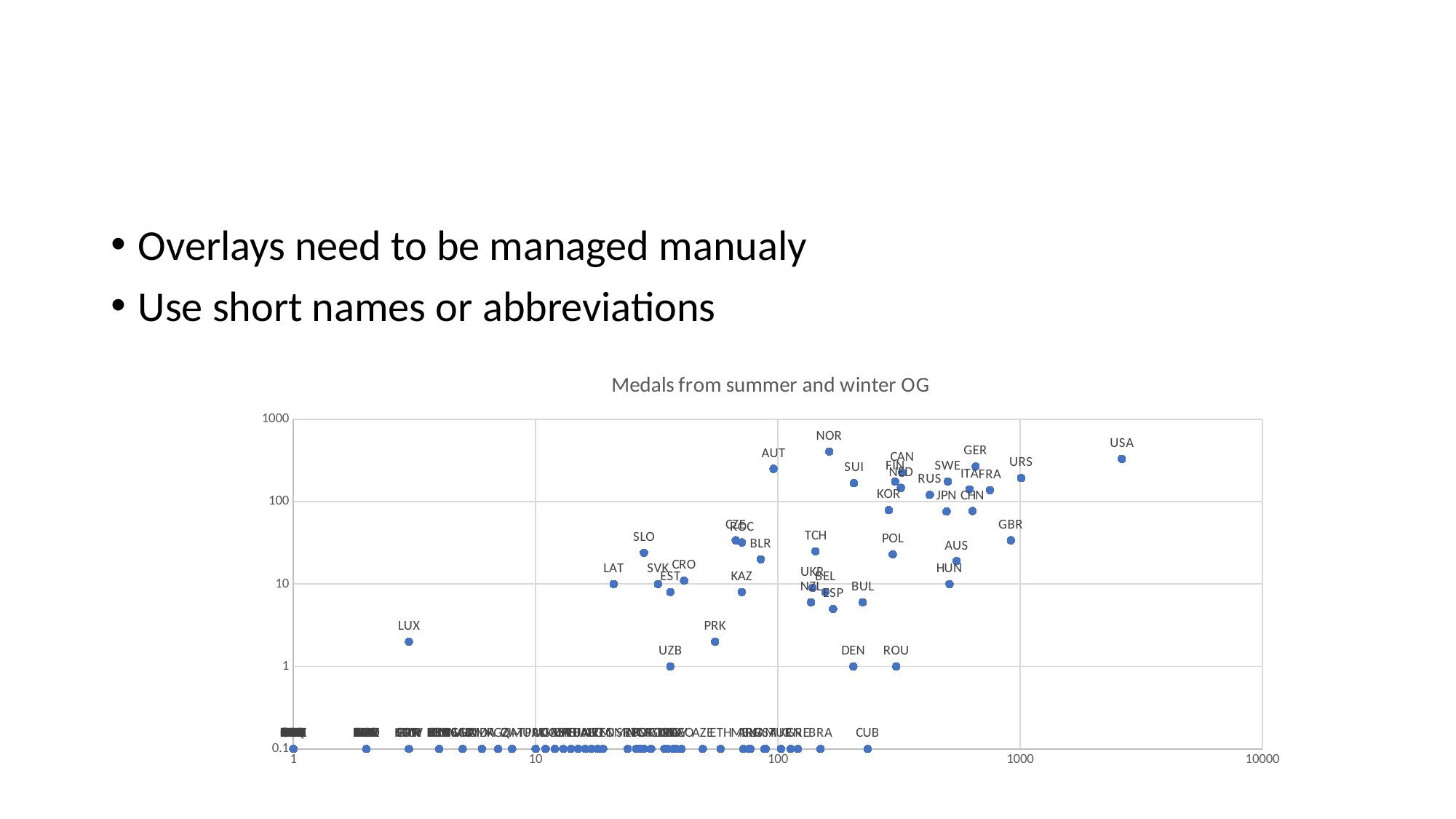
What is the title of the chart? Medals from summer and winter OG Is the vertical-axis value for PRK greater or less than 1? greater Is the vertical-axis value for GBR greater or less than 100? less What kind of chart is shown on the slide? scatter chart Is the vertical-axis value for USA greater or less than 100? greater Which country has the highest value on the horizontal axis? USA What is the vertical-axis value for UZB? 1 Which country has the highest value on the vertical axis? NOR Which has the larger horizontal-axis value, USA or NOR? USA Which has the larger vertical-axis value, SLO or LAT? SLO